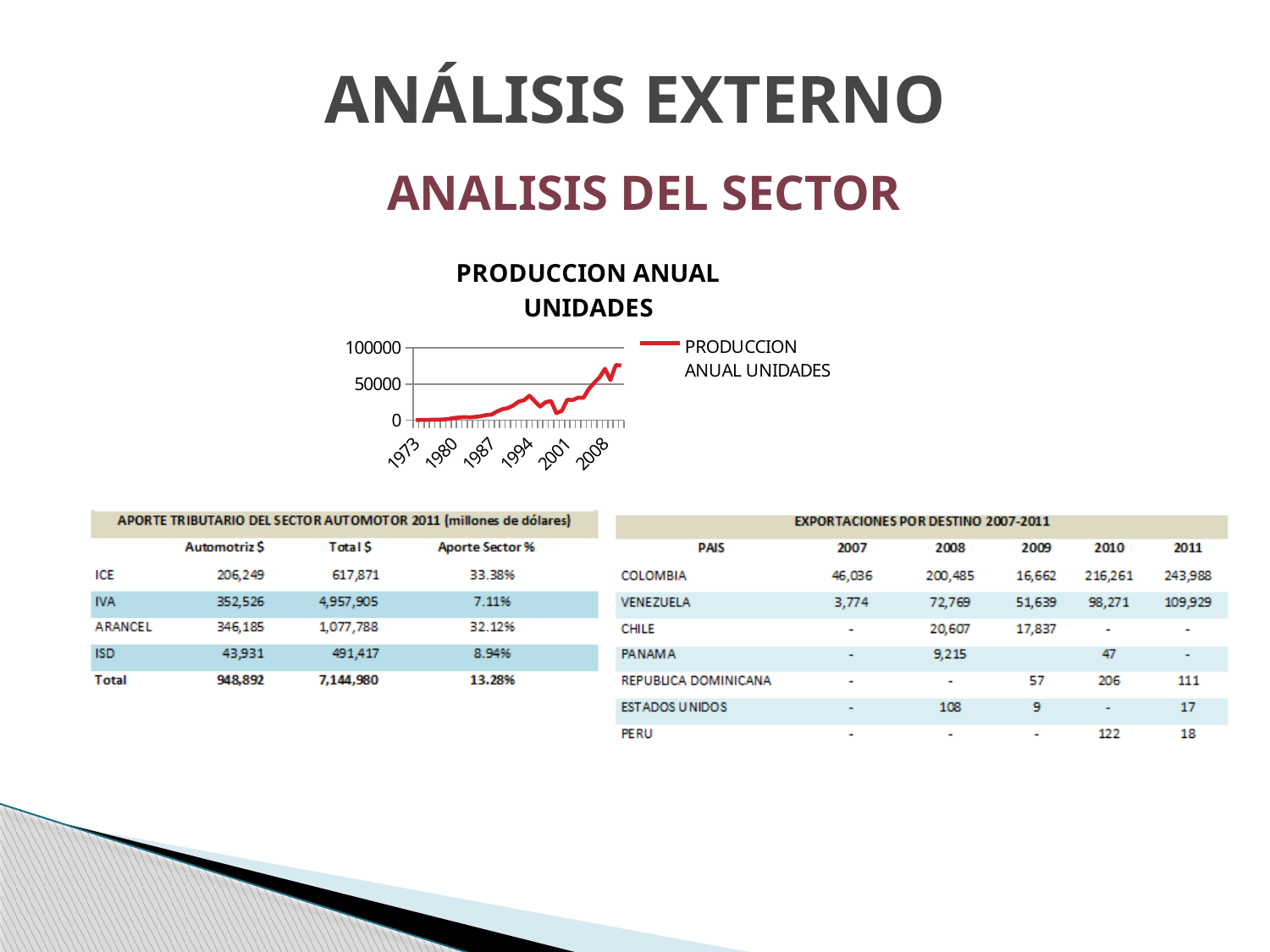
In the PRODUCCION ANUAL UNIDADES chart, is the value for 1973 greater or less than 50000? less In the PRODUCCION ANUAL UNIDADES chart, is the value for 1987 greater or less than 50000? less How many series does the legend of the PRODUCCION ANUAL UNIDADES chart list? 1 What colour is the line in the PRODUCCION ANUAL UNIDADES chart? red What kind of chart is shown under the title PRODUCCION ANUAL UNIDADES? line chart Which year is the first label on the x axis of the PRODUCCION ANUAL UNIDADES chart? 1973 Do the values in the PRODUCCION ANUAL UNIDADES chart generally rise or fall from 1973 to 2008? rise In the PRODUCCION ANUAL UNIDADES chart, is the highest value on the line greater or less than 100000? less What is the name of the series shown in the legend of the line chart? PRODUCCION ANUAL UNIDADES